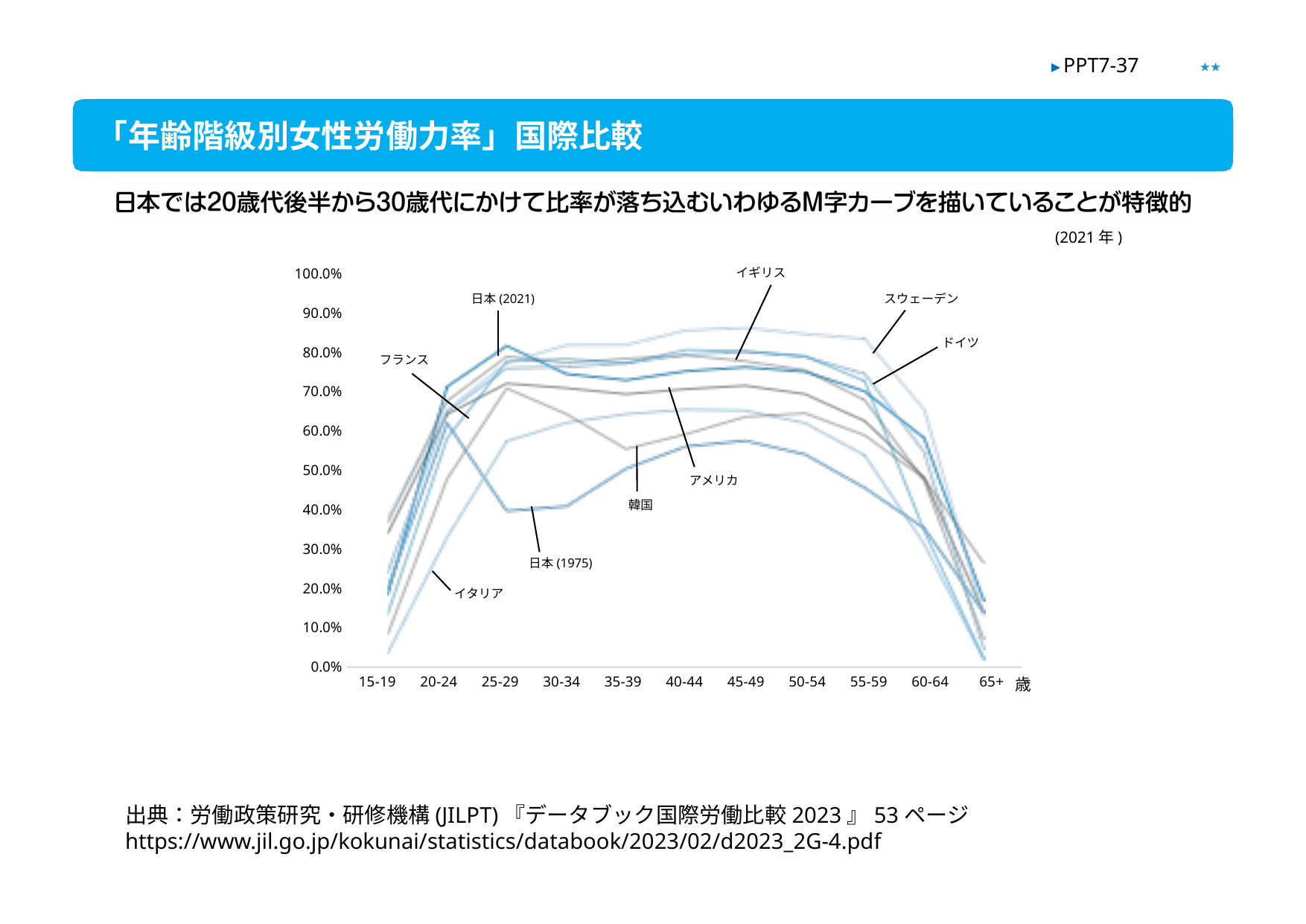
Do the lines generally rise or fall from 55-59 to 65+? fall Is the value for 日本 (1975) at 25-29 greater or less than 50%? less Which series has the lowest value at the 25-29 age group? 日本 (1975) What is the title of the chart on the slide? 「年齢階級別女性労働力率」国際比較 How many age groups are shown along the x axis? 11 Does the 日本 (1975) line rise or fall from 20-24 to 25-29? fall Is the value for 日本 (2021) at 25-29 greater or less than 70%? greater What year does the chart data refer to, as noted above the chart? 2021年 What kind of chart is shown on the slide? line chart How many labelled lines (countries/series) are plotted on the chart? 9 Is the value for 韓国 at 35-39 greater or less than 60%? less Does the 日本 (2021) line rise or fall from 15-19 to 25-29? rise